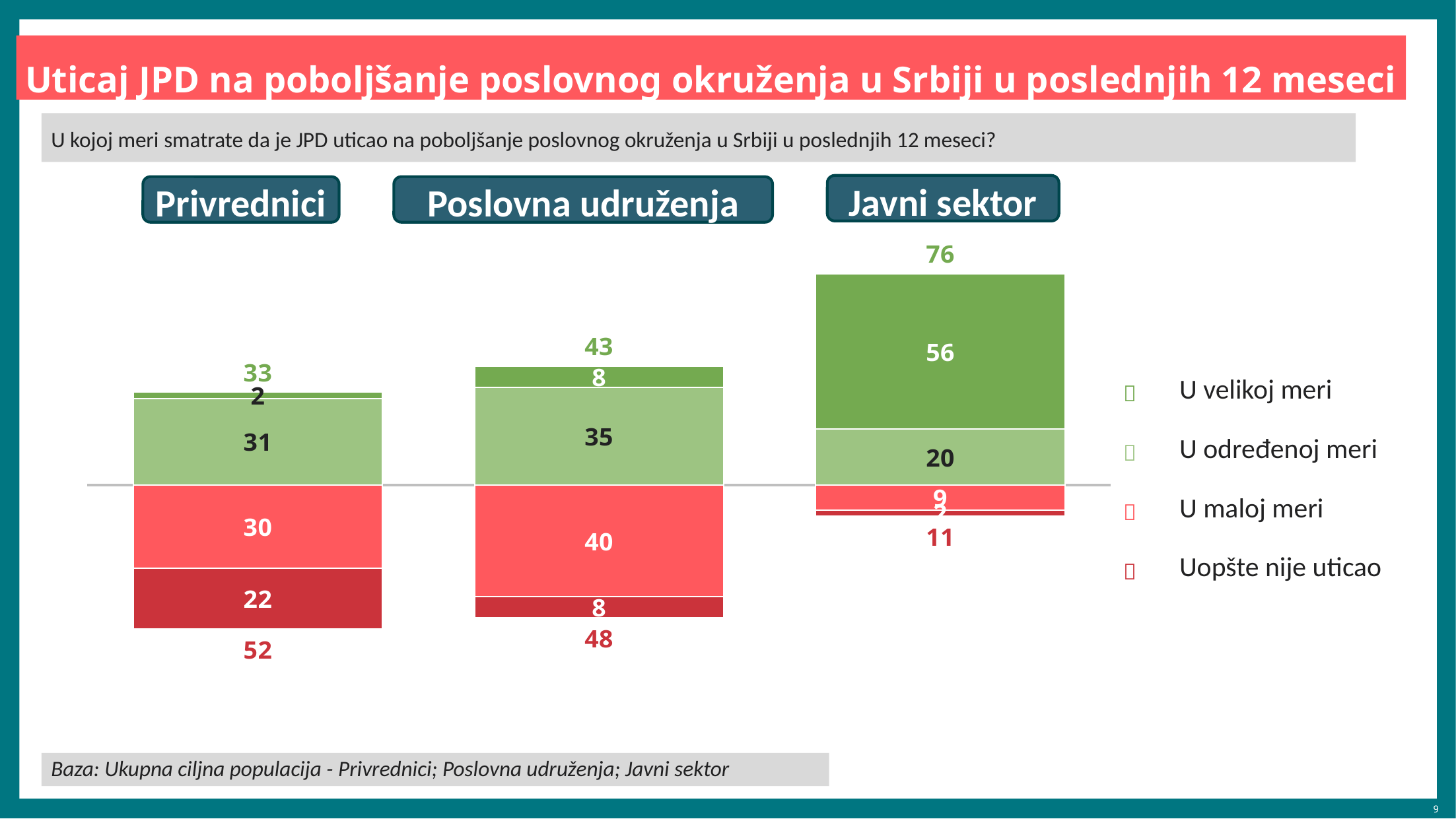
How many series does the legend list? 4 What is the value for "U određenoj meri" for Privrednici? 31 Which is larger: the "U određenoj meri" value for Poslovna udruženja or for Javni sektor? Poslovna udruženja Which group has the highest value for "U velikoj meri"? Javni sektor What is the value for "U maloj meri" for Poslovna udruženja? 40 What is the value for "Uopšte nije uticao" for Privrednici? 22 What kind of chart is shown on the slide? Stacked bar chart What is the combined total of "U velikoj meri" and "U određenoj meri" for Poslovna udruženja? 43 What is the difference between the "U maloj meri" values for Poslovna udruženja and Privrednici? 10 What is the value for "U velikoj meri" for Javni sektor? 56 Which group has the lowest value for "Uopšte nije uticao"? Javni sektor How many groups (categories) are shown in the chart? 3